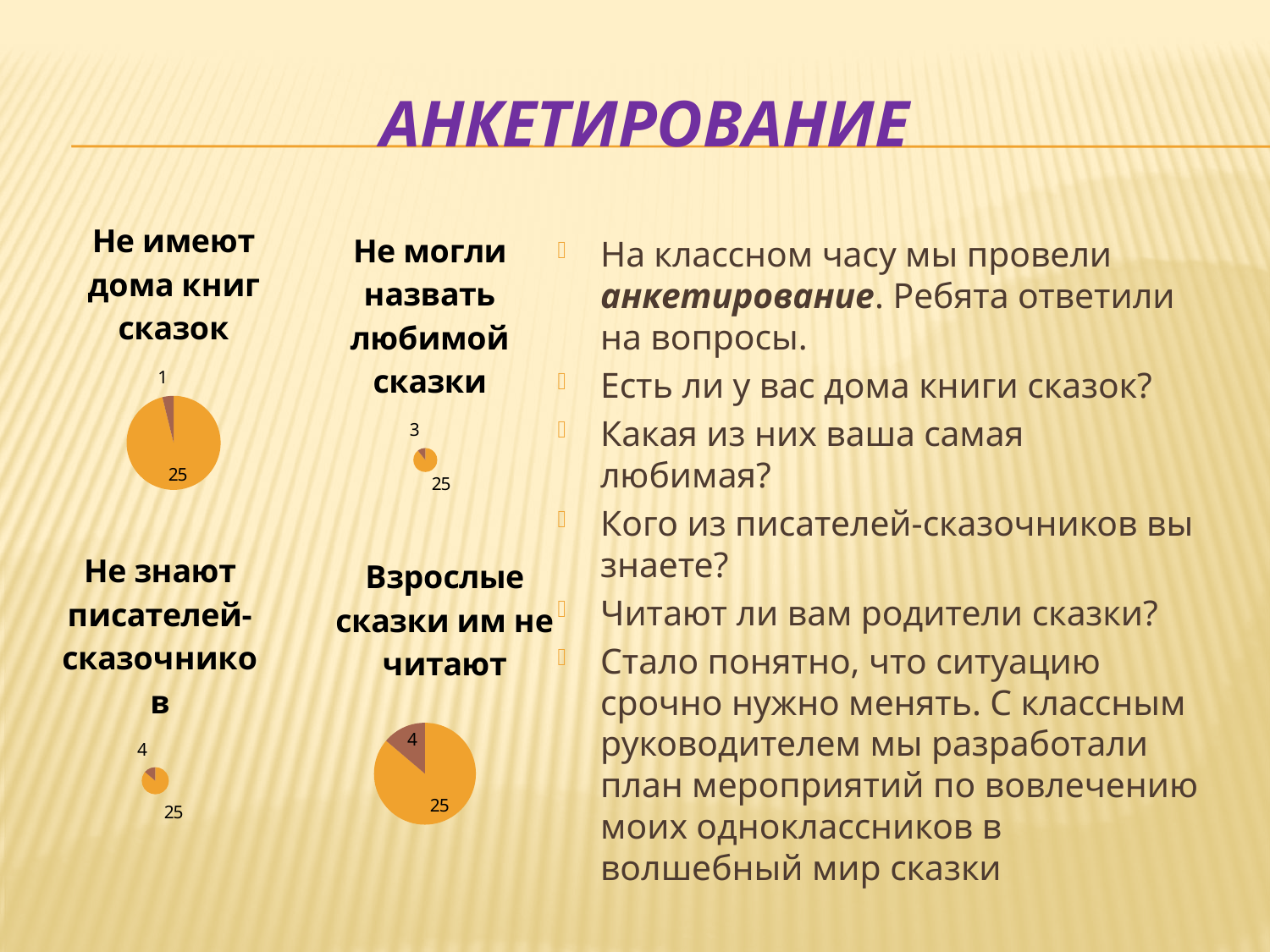
How many slices does the "Взрослые сказки им не читают" pie chart have? 2 In the "Не знают писателей-сказочников" chart, what value is labelled on the small brown slice? 4 In the "Не знают писателей-сказочников" chart, which slice is larger, the one labelled 4 or the one labelled 25? 25 In the "Не имеют дома книг сказок" chart, which slice is larger, the one labelled 1 or the one labelled 25? 25 In the "Взрослые сказки им не читают" chart, what value is labelled on the large orange slice? 25 In the "Не могли назвать любимой сказки" chart, what value is labelled on the small brown slice? 3 In the "Не имеют дома книг сказок" chart, what value is labelled on the small brown slice? 1 What is the title of the pie chart in the bottom-right position of the chart group? Взрослые сказки им не читают How many pie charts are shown on the slide? 4 In the "Не имеют дома книг сказок" chart, what is the difference between the two labelled values? 24 What kind of chart is used for "Не имеют дома книг сказок"? pie chart In the "Не могли назвать любимой сказки" chart, what is the difference between the two labelled values? 22